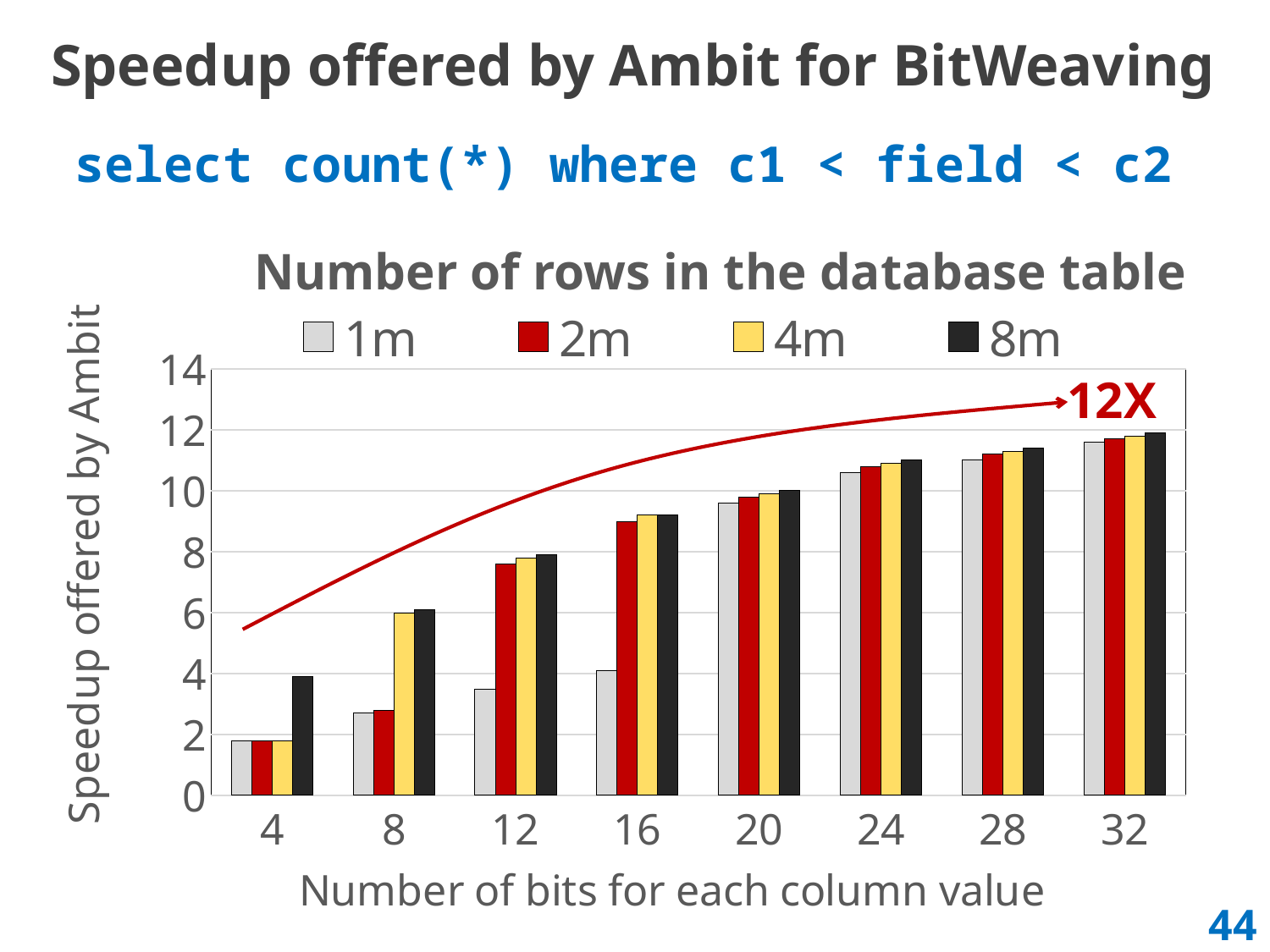
Is the speedup for 1m at 20 bits greater or less than 8? greater Is the speedup for 1m at 8 bits greater or less than 4? less How many series does the legend list? 4 At 8 bits, which is larger: the speedup for 4m or for 1m? 4m Is the speedup for 2m at 12 bits greater or less than 8? less Which series has the highest speedup at 4 bits? 8m What speedup value is called out by the red annotation on the chart? 12X How many categories are shown on the x axis? 8 Do the speedup values rise or fall as the number of bits increases? rise What kind of chart is shown on the slide? bar chart Which series has the lowest speedup at 12 bits? 1m